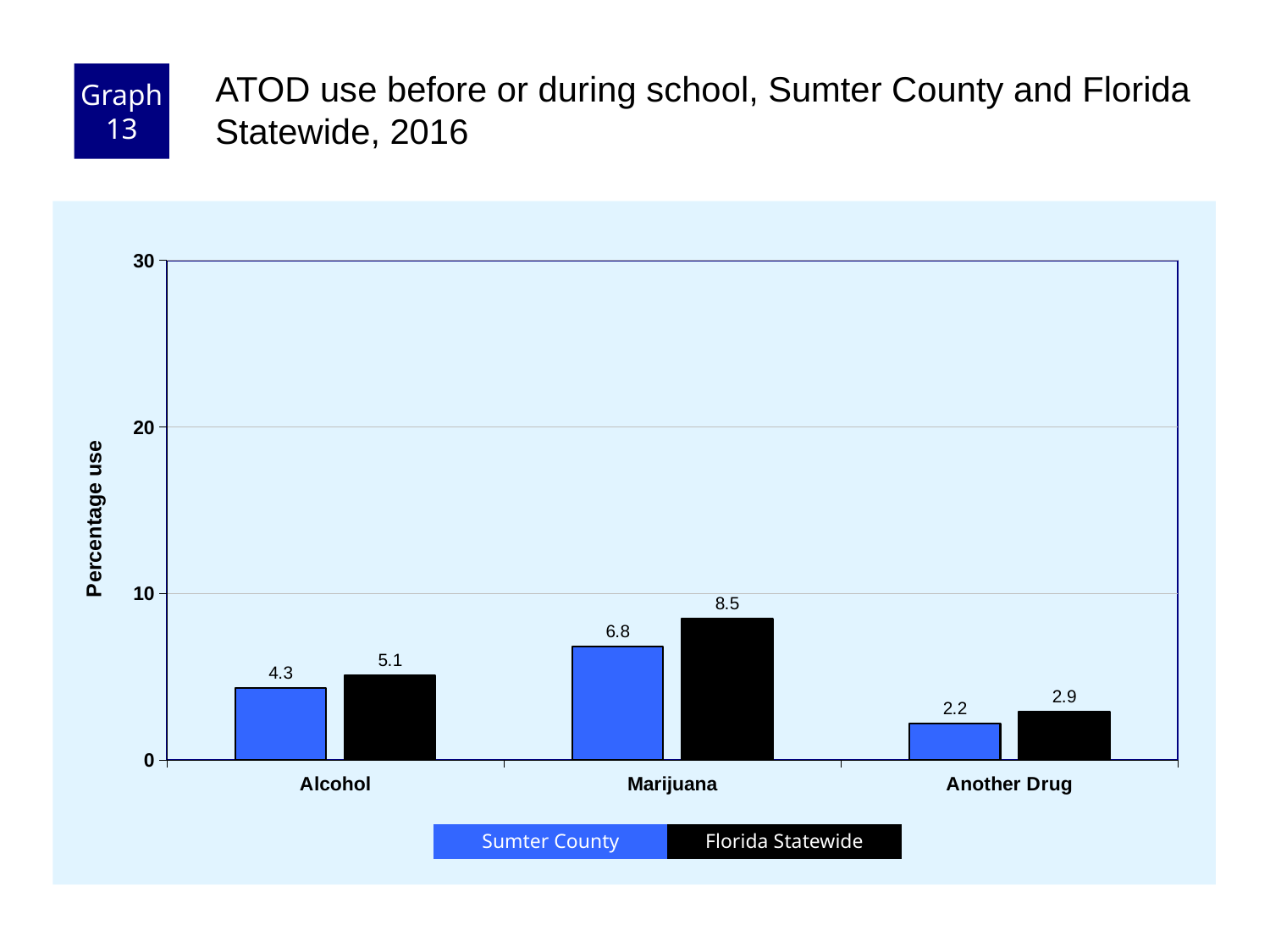
What is the Florida Statewide value for Marijuana? 8.5 Which is larger for Alcohol: Sumter County or Florida Statewide? Florida Statewide How many series does the legend list? 2 How many categories are shown on the x axis? 3 Is the Florida Statewide value for Marijuana greater or less than 10? less What is the Sumter County value for Another Drug? 2.2 Which category has the highest Florida Statewide value? Marijuana What is the Sumter County value for Alcohol? 4.3 Which category has the lowest Sumter County value? Another Drug What is the difference between the Florida Statewide and Sumter County values for Marijuana? 1.7 What kind of chart is shown? bar chart What is the label of the y axis? Percentage use